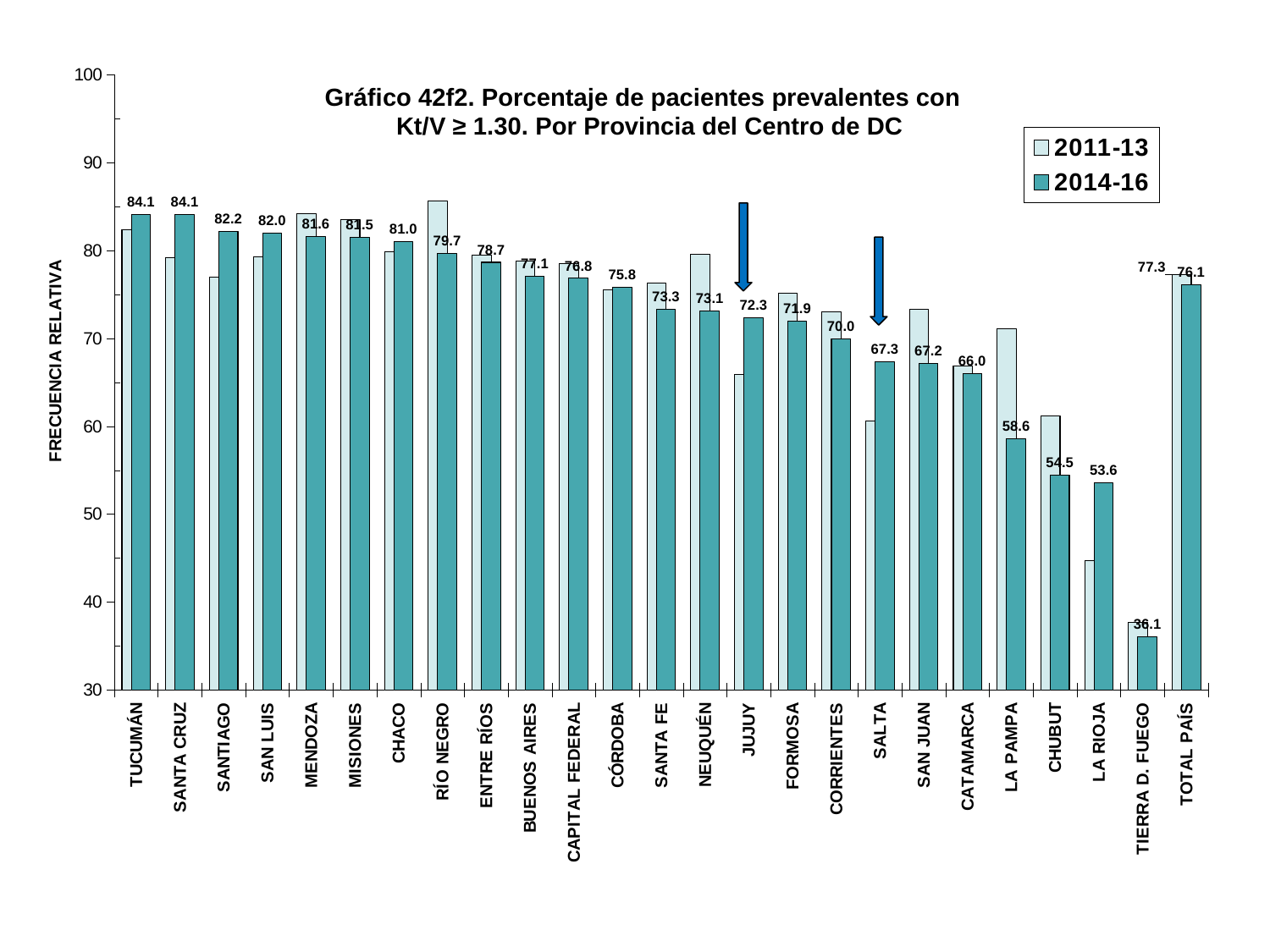
Which province has the lowest 2014-16 value? TIERRA D. FUEGO What is the difference between the 2011-13 and 2014-16 values for TOTAL PAÍS? 1.2 How many categories are shown on the x axis? 25 What is the 2014-16 value for JUJUY? 72.3 Is the 2011-13 value for RÍO NEGRO greater or less than 80? greater What is the difference between the 2014-16 values for SALTA and SAN JUAN? 0.1 Which has the larger 2014-16 value, CÓRDOBA or SANTA FE? CÓRDOBA What kind of chart is this? bar chart Is the 2011-13 value for LA RIOJA greater or less than 50? less How many series does the legend list? 2 What is the 2011-13 value for TOTAL PAÍS? 77.3 What is the 2014-16 value for CHUBUT? 54.5